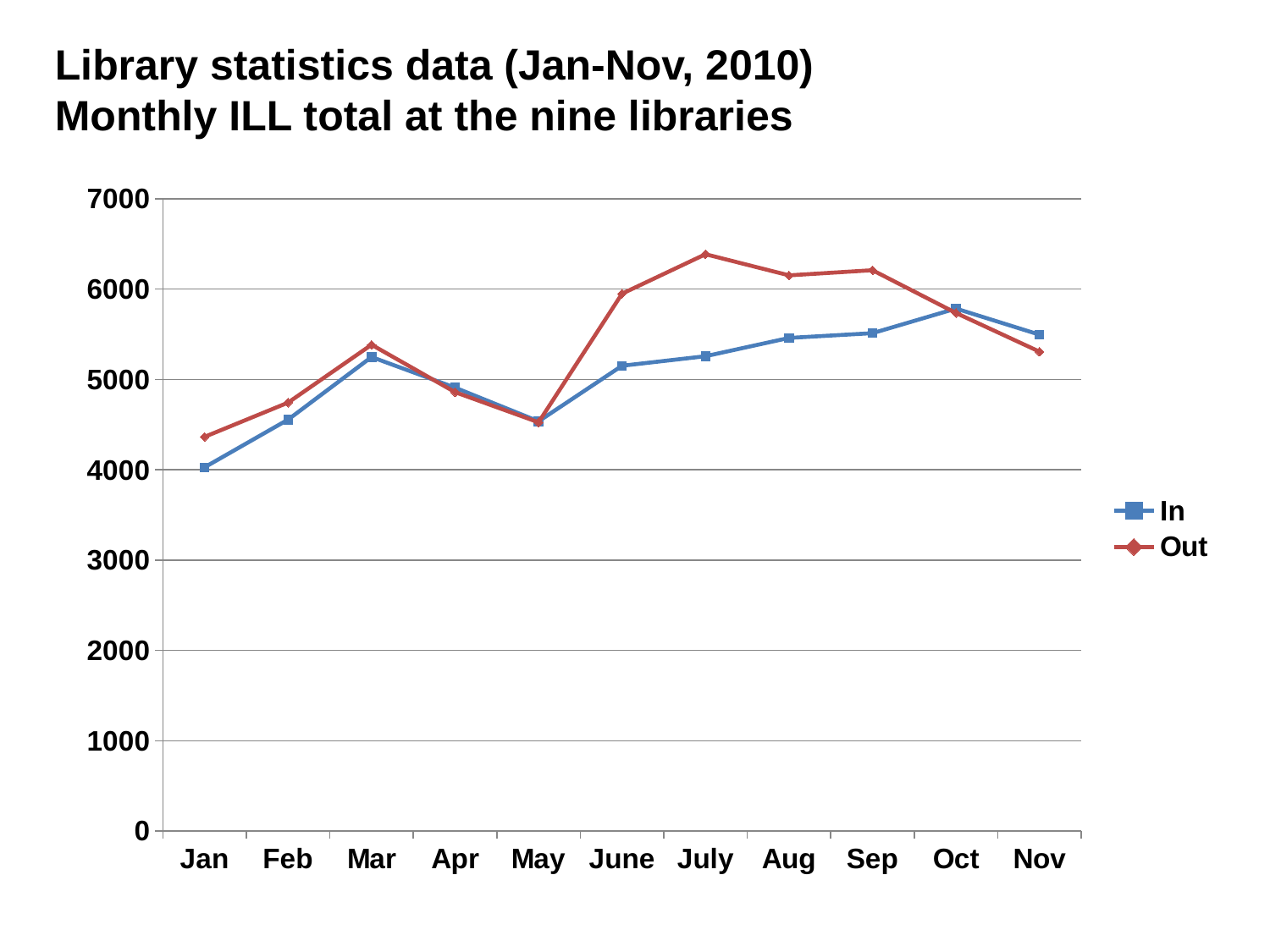
How many series does the legend list? 2 What kind of chart is shown on the slide? line chart Which month has the highest value for the Out series? July Which month has the highest value for the In series? Oct Which month has the lowest value for the In series? Jan How many months are plotted along the x axis? 11 In July, which series has the larger value, In or Out? Out Is the value for Out in July greater or less than 6000? greater What are the two series named in the legend? In and Out Is the value for Out in May greater or less than 5000? less Does the In series rise or fall from May to Oct? rise Is the value for In in Oct greater or less than 6000? less